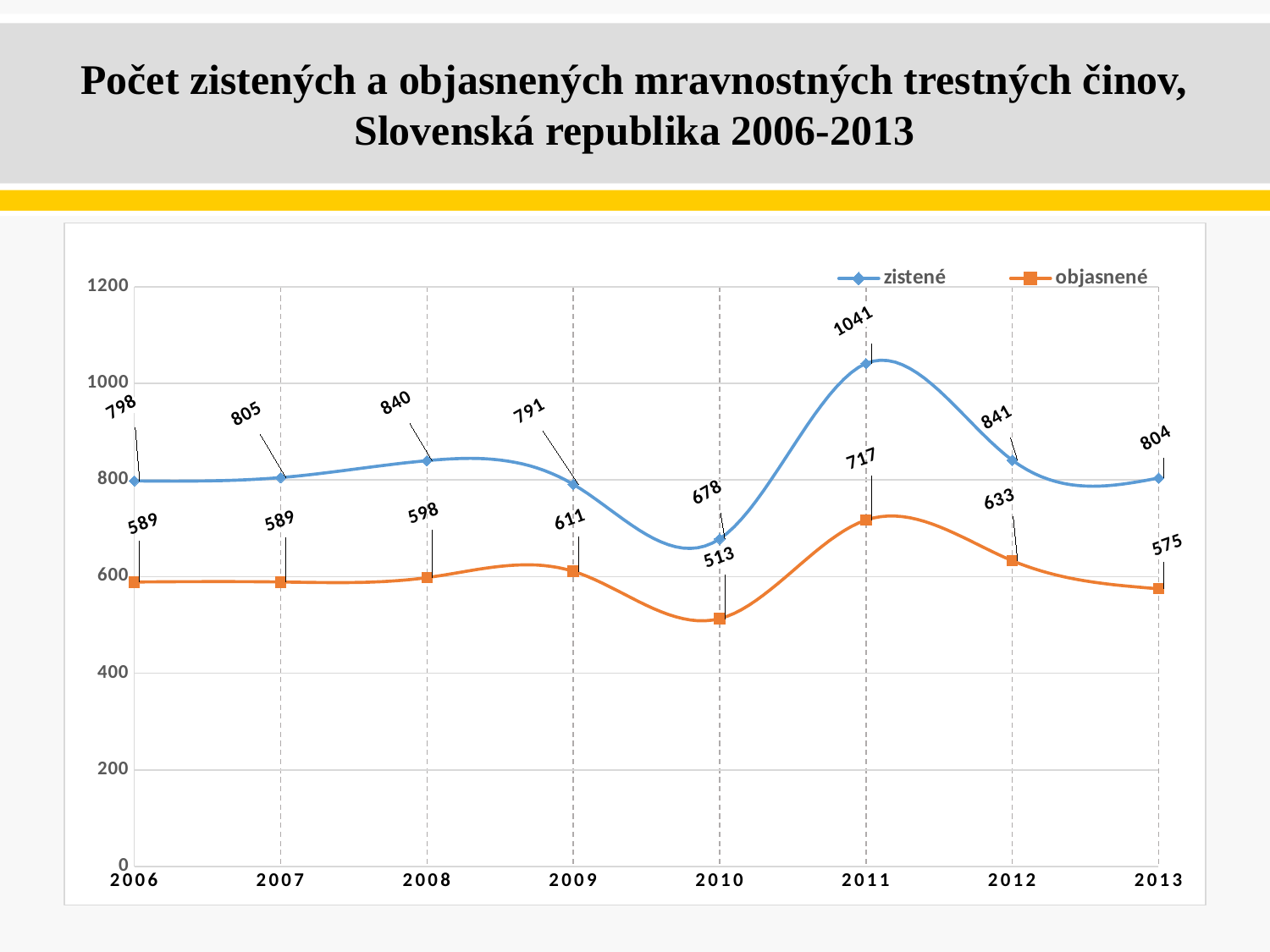
Does the objasnené series rise or fall from 2011 to 2013? fall What is the difference between the zistené and objasnené values in 2011? 324 What is the value of the objasnené series in 2010? 513 Is the zistené value in 2010 greater or less than 800? less How many series does the legend list? 2 Which is larger, the zistené value in 2008 or the zistené value in 2009? 2008 What is the value of the zistené series in 2013? 804 In which year is the objasnené series lowest? 2010 What is the value of the zistené series in 2011? 1041 How many years are shown on the x axis? 8 What kind of chart is shown on the slide? line chart In which year is the zistené series highest? 2011